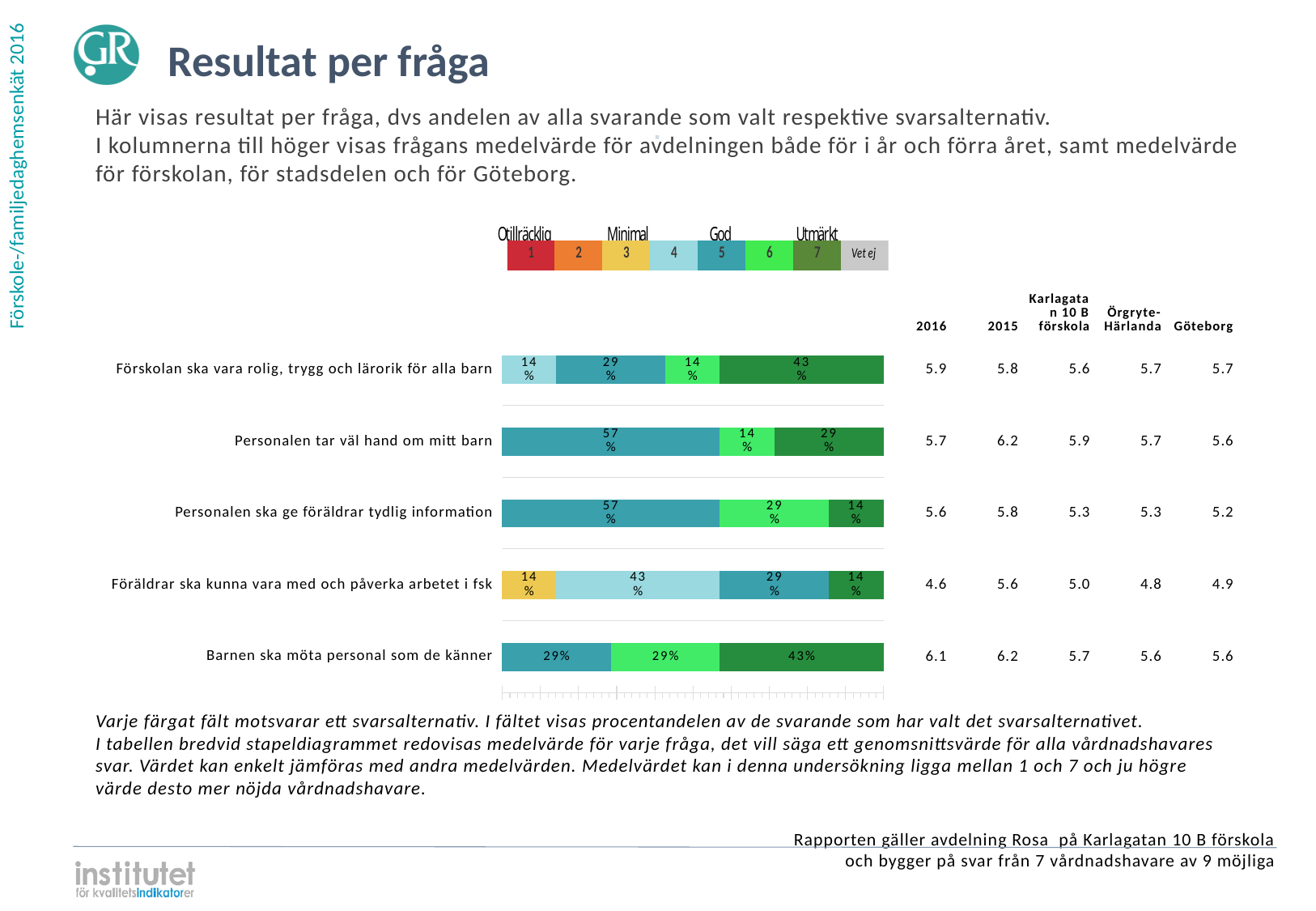
What label does the legend give to rating 7? Utmärkt What percentage of respondents chose rating 7 (dark green) for "Barnen ska möta personal som de känner"? 43% What kind of chart is shown on the slide? Stacked bar chart Which question has the highest mean value in the 2016 column next to the chart? Barnen ska möta personal som de känner Which question has the lowest mean value in the 2016 column next to the chart? Föräldrar ska kunna vara med och påverka arbetet i fsk What is the total of the labelled segments in the bar for "Personalen tar väl hand om mitt barn"? 100% How many questions (categories) are plotted in the bar chart? 5 What percentage of respondents chose rating 5 (teal) for "Personalen tar väl hand om mitt barn"? 57% What percentage of respondents chose rating 4 (light blue) for "Föräldrar ska kunna vara med och påverka arbetet i fsk"? 43% For "Personalen ska ge föräldrar tydlig information", how many percentage points larger is the rating 5 segment than the rating 7 segment? 43 percentage points How many entries does the colour legend above the chart list? 8 Which has a larger rating 7 (dark green) share: "Förskolan ska vara rolig, trygg och lärorik för alla barn" or "Personalen tar väl hand om mitt barn"? Förskolan ska vara rolig, trygg och lärorik för alla barn